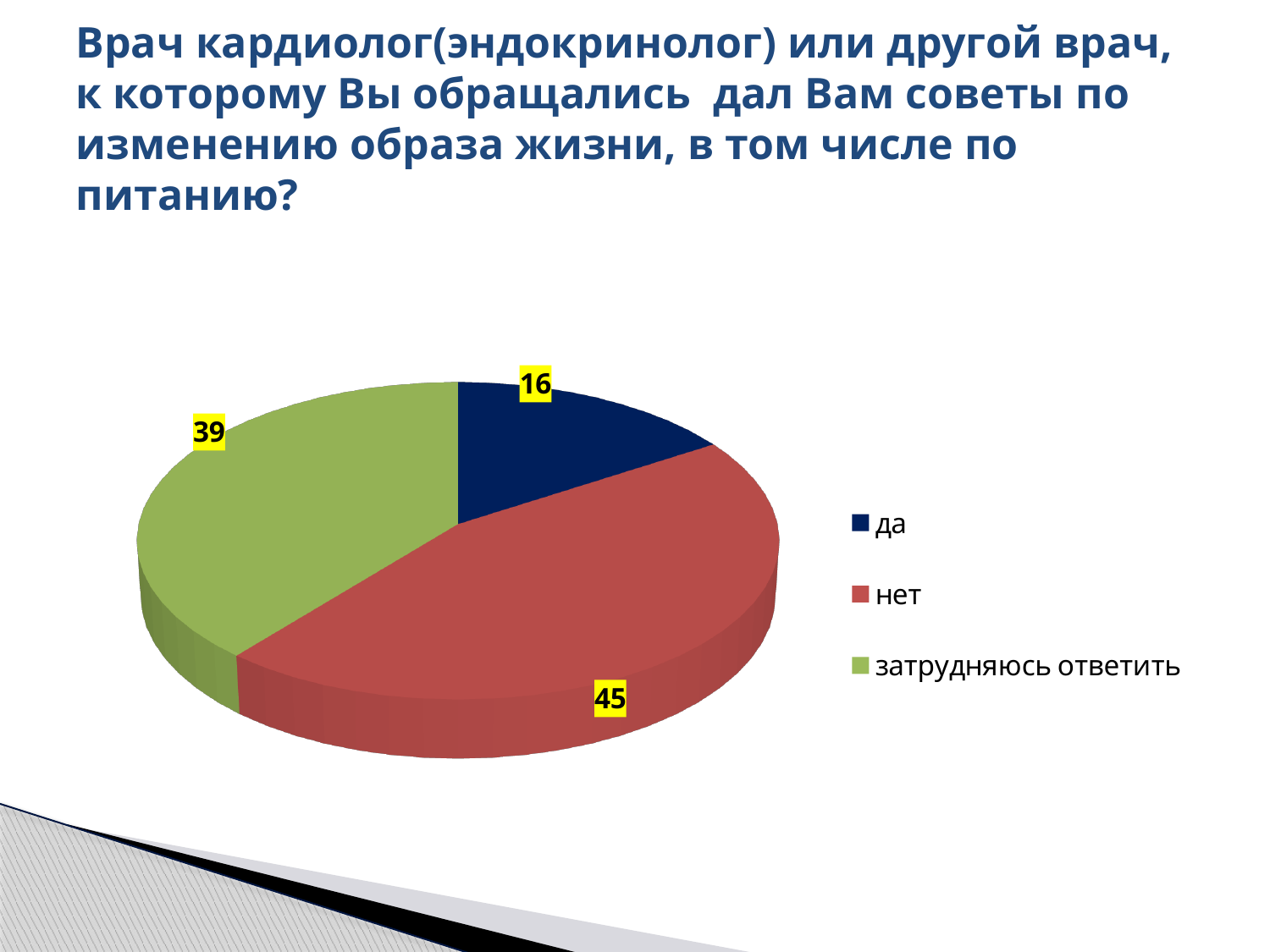
What value is shown for the "нет" slice of the pie chart? 45 What colour is the "нет" slice in the pie chart? red What is the total of all the values shown on the pie chart? 100 Which category has the smallest slice in the pie chart? да What value is shown for the "да" slice of the pie chart? 16 What type of chart is shown on the slide? pie chart Which is larger, the value for "затрудняюсь ответить" or the value for "да"? затрудняюсь ответить What value is shown for the "затрудняюсь ответить" slice of the pie chart? 39 What is the difference between the values for "нет" and "да"? 29 Which category has the largest slice in the pie chart? нет How many slices does the pie chart have? 3 What is the difference between the values for "нет" and "затрудняюсь ответить"? 6